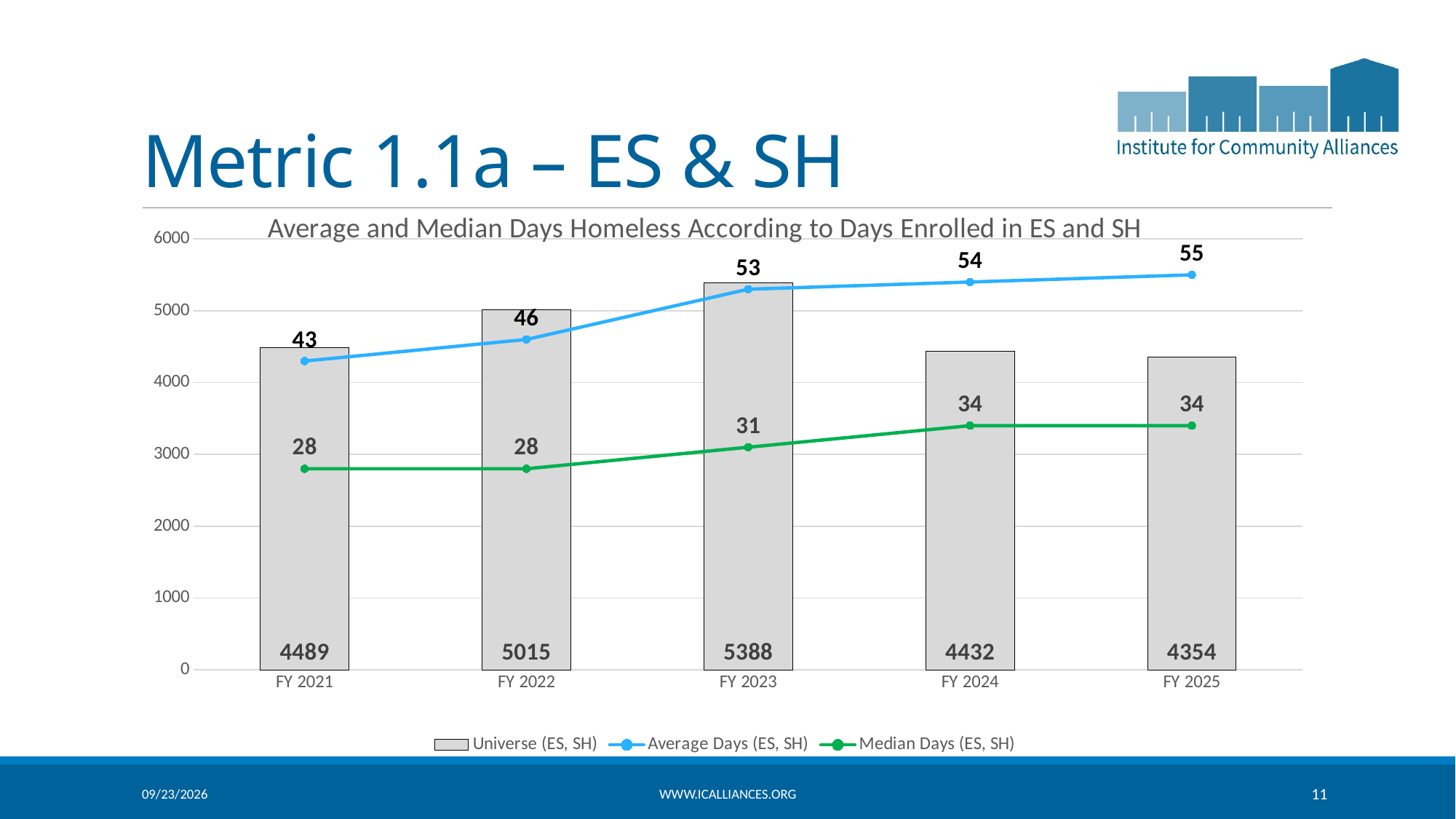
Which fiscal year has the highest Universe (ES, SH) value? FY 2023 Is the Universe (ES, SH) bar for FY 2024 greater or less than 5000? less How many fiscal years are shown on the x axis? 5 How many series does the legend list? 3 What is the Universe (ES, SH) value for FY 2023? 5388 Which is larger, the Average Days (ES, SH) value for FY 2022 or for FY 2023? FY 2023 Does the Average Days (ES, SH) line rise or fall from FY 2021 to FY 2025? rise What is the difference between the Universe (ES, SH) values for FY 2022 and FY 2021? 526 What is the Median Days (ES, SH) value for FY 2024? 34 Which fiscal year has the lowest Universe (ES, SH) value? FY 2025 What is the Average Days (ES, SH) value for FY 2021? 43 What is the title of the chart? Average and Median Days Homeless According to Days Enrolled in ES and SH